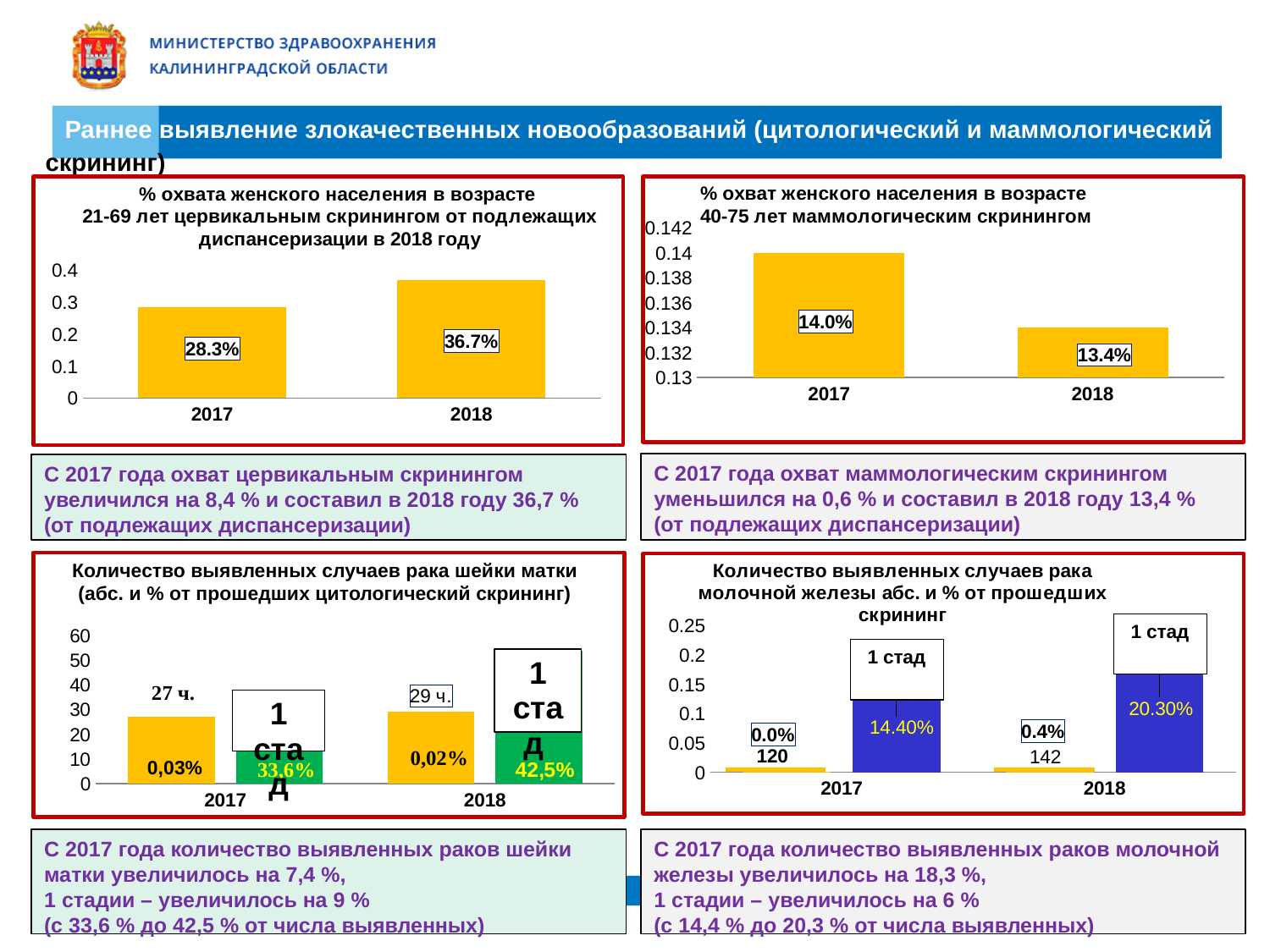
In the top-left chart on cervical screening coverage (21-69 years), what is the value for 2018? 36.7% In the top-right chart on mammography screening coverage (40-75 years), what is the value for 2017? 14.0% In the top-left chart on cervical screening coverage (21-69 years), what is the value for 2017? 28.3% In the bottom-right chart on detected breast cancer cases, what stage 1 percentage is shown for 2017? 14.40% In the bottom-right chart on detected breast cancer cases, which year has the higher stage 1 percentage, 2017 or 2018? 2018 In the top-right chart on mammography screening coverage, do the values rise or fall from 2017 to 2018? fall In the bottom-left chart on detected cervical cancer cases, what share of stage 1 cases is shown for 2017? 33,6% In the bottom-right chart on detected breast cancer cases, what is the number of cases shown for 2018? 142 What type of chart is the top-left chart on cervical screening coverage? bar chart In the bottom-left chart on detected cervical cancer cases, what is the number of cases shown for 2018? 29 ч. In the top-right chart on mammography screening coverage (40-75 years), which year has the lower value? 2018 In the top-left chart on cervical screening coverage, by how many percentage points did the value change from 2017 to 2018? 8.4